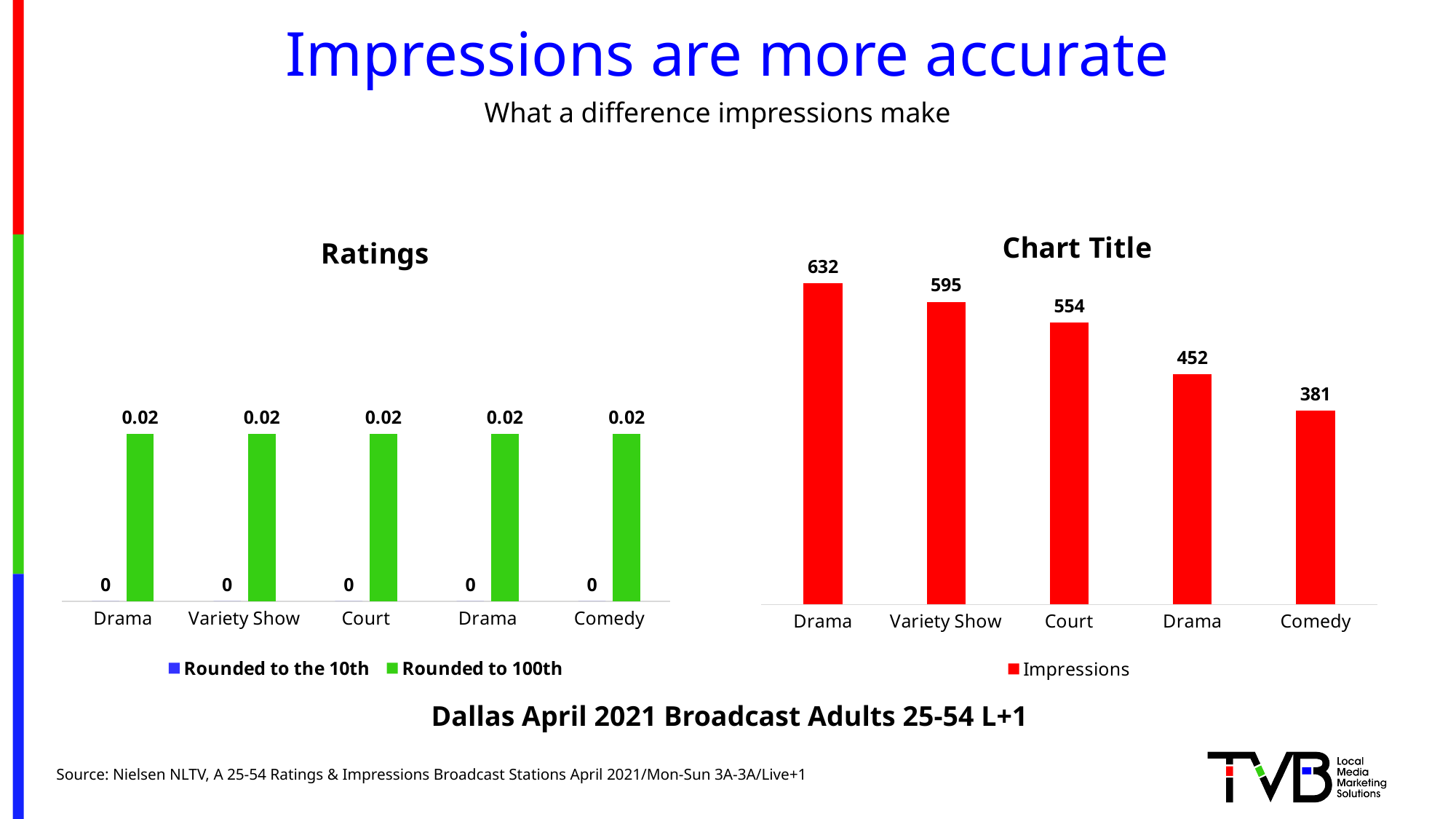
In the right-hand chart titled "Chart Title", which has a larger Impressions value, Court or Comedy? Court How many series does the legend of the left-hand chart titled "Ratings" list? 2 In the right-hand chart titled "Chart Title", which category has the lowest Impressions value? Comedy In the left-hand chart titled "Ratings", what is the "Rounded to the 10th" value for Comedy? 0 In the left-hand chart titled "Ratings", what is the "Rounded to 100th" value for Court? 0.02 In the right-hand chart titled "Chart Title", what is the Impressions value for Comedy? 381 In the right-hand chart titled "Chart Title", what is the difference between the Impressions for Variety Show and Comedy? 214 In the right-hand chart titled "Chart Title", what is the Impressions value for Court? 554 What kind of chart is the right-hand chart titled "Chart Title"? bar chart In the right-hand chart titled "Chart Title", do the Impressions values rise or fall from left to right? fall In the right-hand chart titled "Chart Title", what is the Impressions value for Variety Show? 595 In the right-hand chart titled "Chart Title", which category has the highest Impressions value? Drama (first bar)